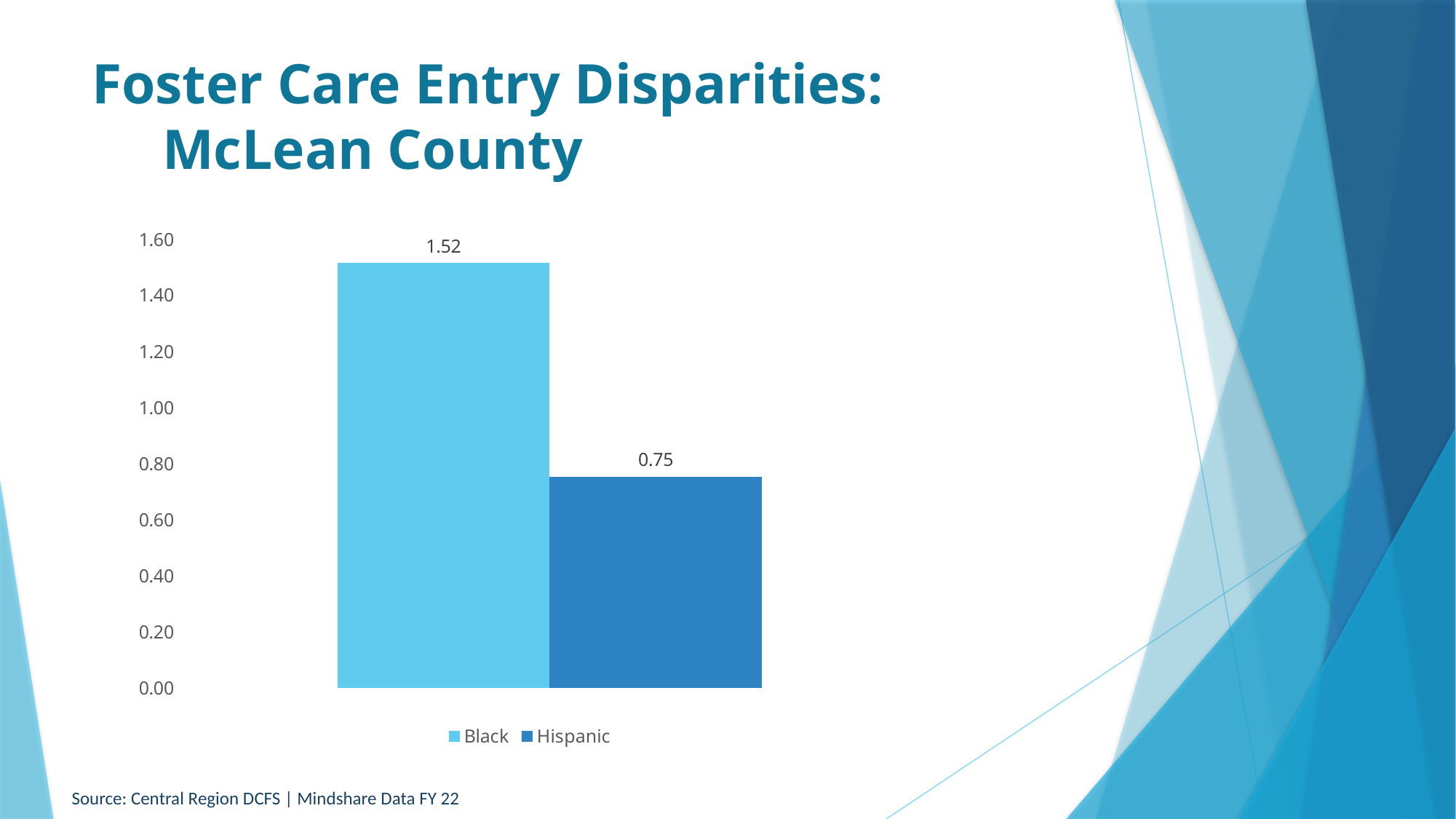
What is the highest value shown on the vertical axis? 1.60 How many series does the legend list? 2 What is the value for Black? 1.52 What is the value for Hispanic? 0.75 Is the value for Black greater or less than 1.00? greater What is the difference between the Black and Hispanic values? 0.77 Which series has the highest value? Black Is the value for Hispanic greater or less than 0.80? less What kind of chart is shown on the slide? bar chart Which is larger, the value for Black or the value for Hispanic? Black What is the title of the slide? Foster Care Entry Disparities: McLean County Which series has the lowest value? Hispanic